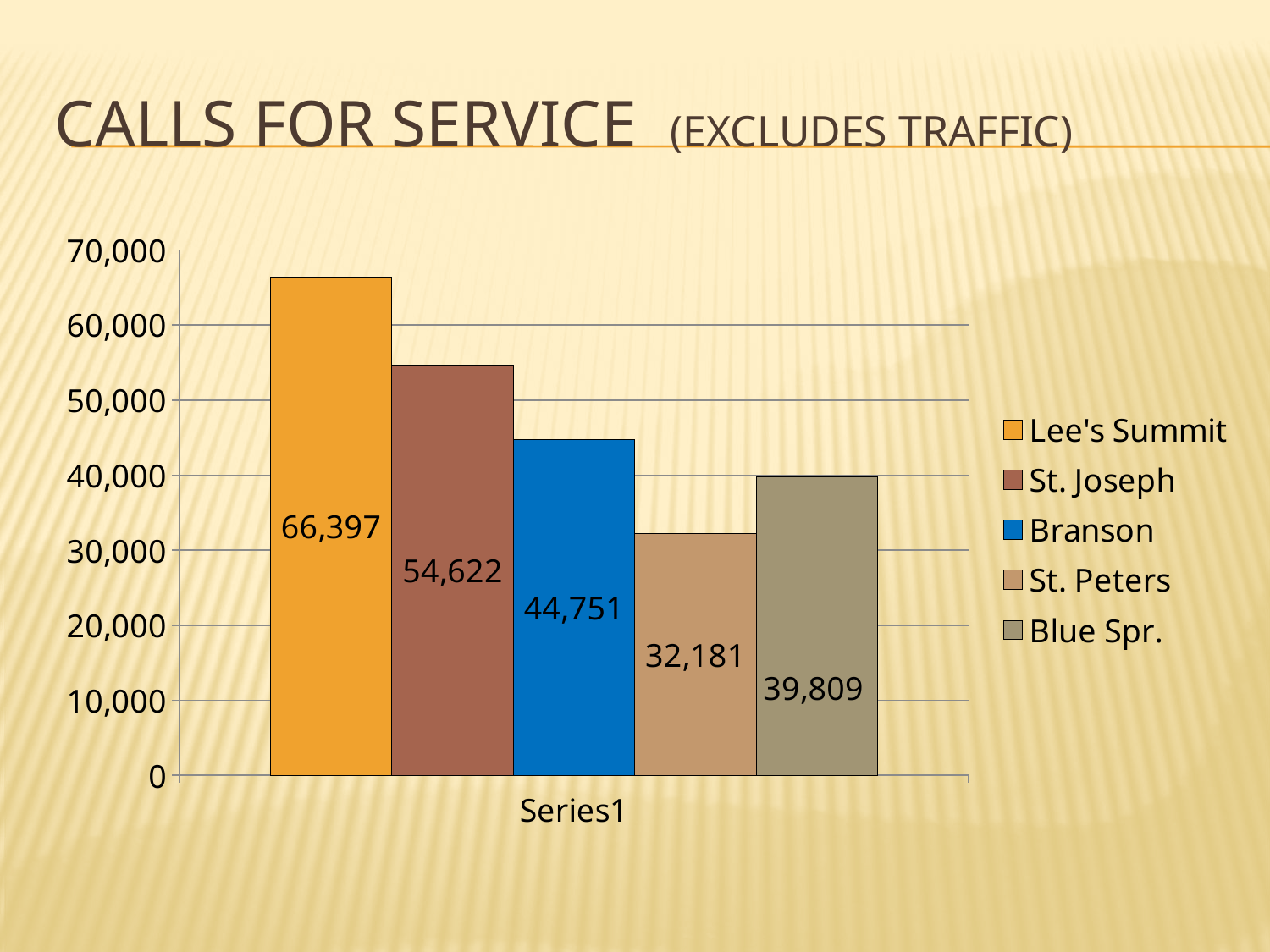
What is the value for St. Peters? 32,181 Is the value for Blue Spr. greater or less than 40,000? less What is the value for Blue Spr.? 39,809 Which city has the lowest number of calls for service? St. Peters Which is larger, the value for St. Joseph or the value for Branson? St. Joseph What is the difference between the values for Lee's Summit and St. Joseph? 11,775 What kind of chart is shown on the slide? bar chart How many series does the legend list? 5 Which city has the highest number of calls for service? Lee's Summit What is the value for Lee's Summit? 66,397 What is the title of the chart? Calls for Service (Excludes Traffic) What is the difference between the values for Branson and Blue Spr.? 4,942